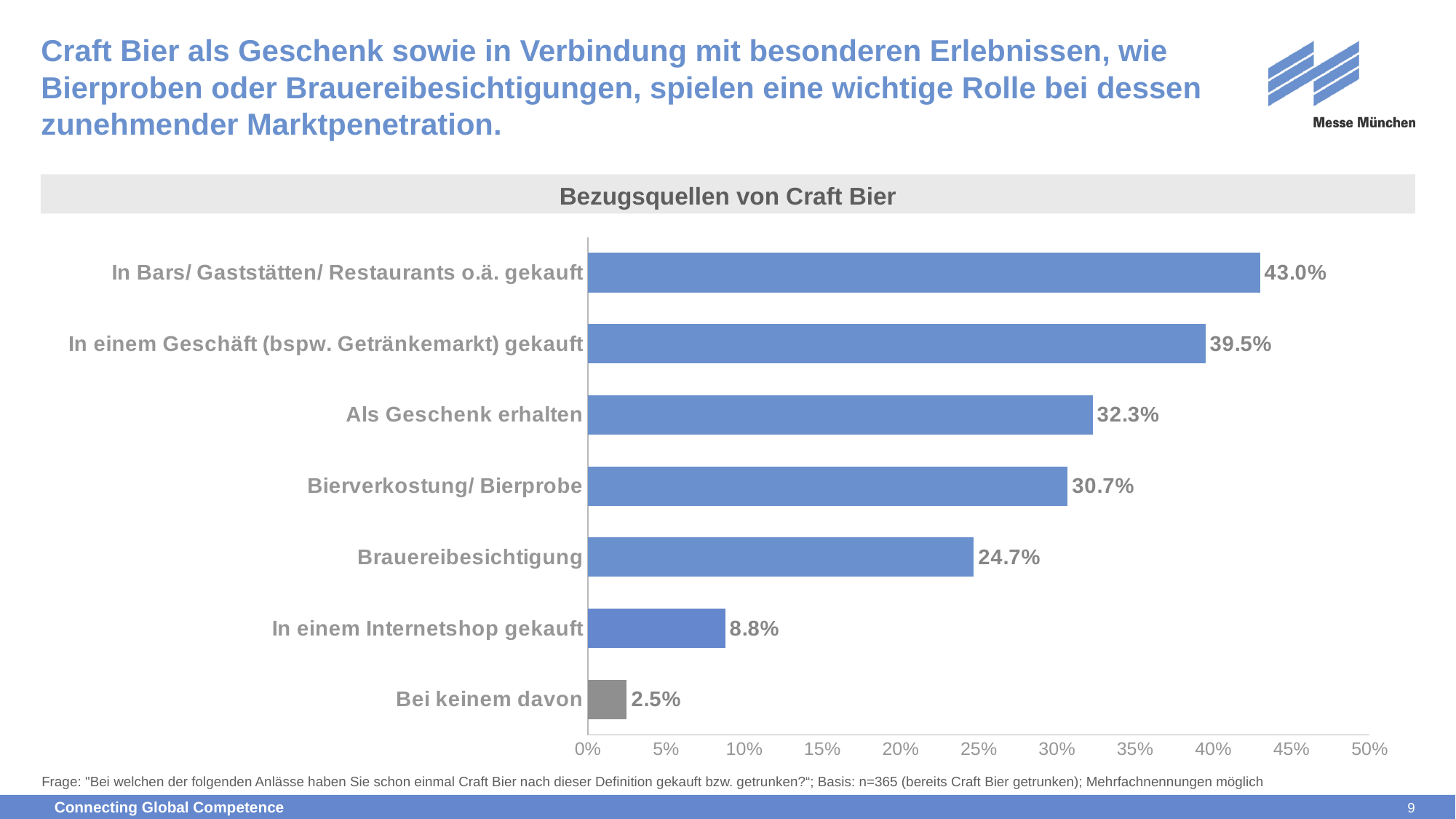
Which is larger: "Als Geschenk erhalten" or "Bierverkostung/ Bierprobe"? Als Geschenk erhalten What is the value for "In einem Internetshop gekauft"? 8.8% What is the difference between "In Bars/ Gaststätten/ Restaurants o.ä. gekauft" and "In einem Geschäft (bspw. Getränkemarkt) gekauft"? 3.5% Which category has the lowest value? Bei keinem davon What is the value for "Brauereibesichtigung"? 24.7% What is the value for "Als Geschenk erhalten"? 32.3% What is the title of the chart? Bezugsquellen von Craft Bier How many categories are shown in the chart? 7 Which category has the highest value? In Bars/ Gaststätten/ Restaurants o.ä. gekauft Is the value for "In einem Geschäft (bspw. Getränkemarkt) gekauft" greater or less than 35%? greater What is the difference between "Bierverkostung/ Bierprobe" and "Brauereibesichtigung"? 6.0% What kind of chart is shown on the slide? Bar chart